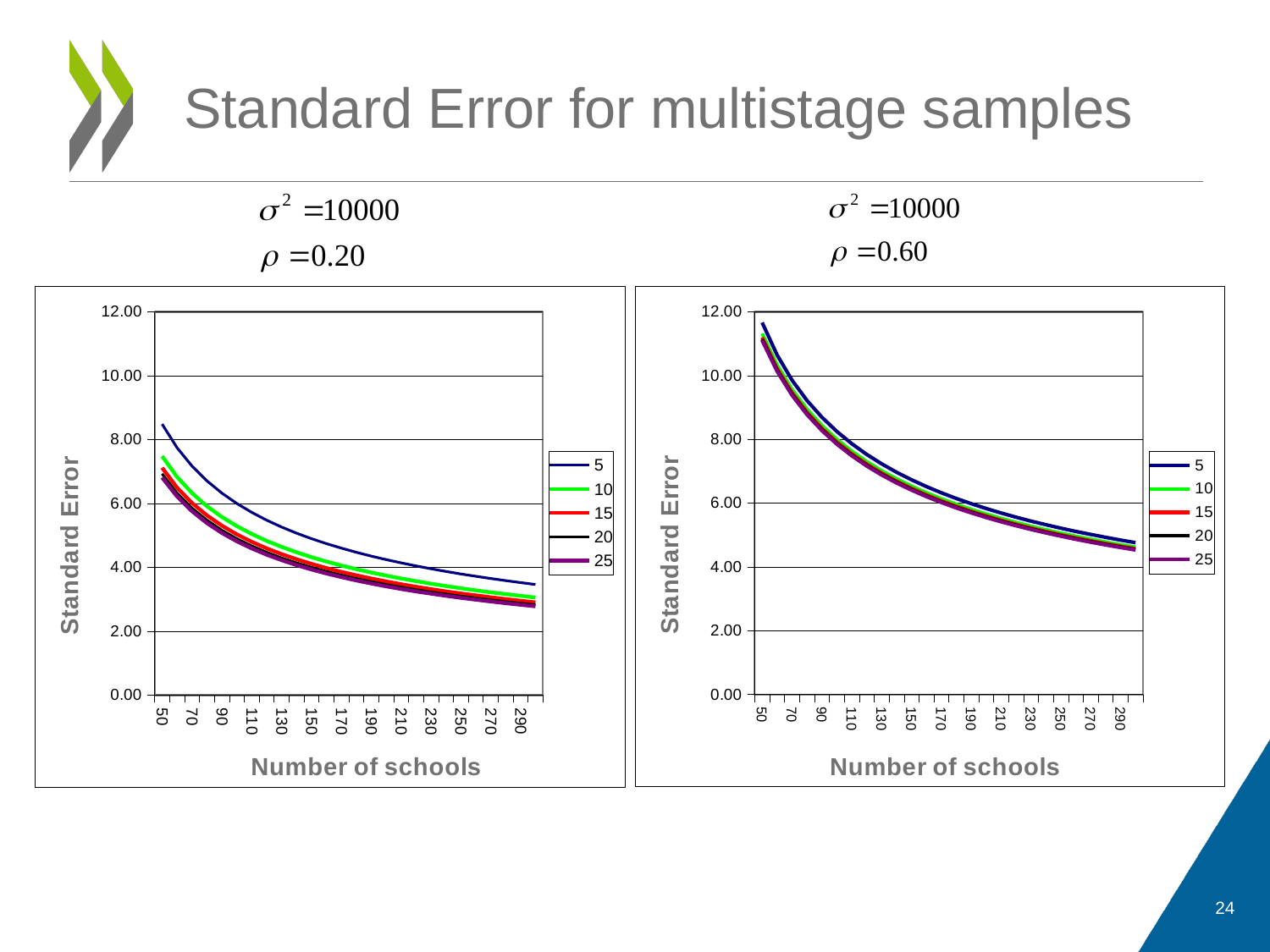
In the left chart (ρ = 0.20), is the value for series 5 at 50 schools greater or less than 8.00? greater What kind of chart is the left chart (ρ = 0.20)? line chart In the right chart (ρ = 0.60), what colour is the line for series 10 in the legend? green In the left chart (ρ = 0.20), does the standard error rise or fall as the number of schools increases? fall In the right chart (ρ = 0.60), is the value for series 5 at 50 schools greater or less than 10.00? greater In the right chart (ρ = 0.60), does the standard error rise or fall as the number of schools increases? fall In the left chart (ρ = 0.20), is the value for series 25 at 50 schools greater or less than 8.00? less What is the label of the x axis on the left chart (ρ = 0.20)? Number of schools How many series does the legend of the right chart (ρ = 0.60) list? 5 In the left chart (ρ = 0.20), which series has the larger value at 50 schools, series 5 or series 25? 5